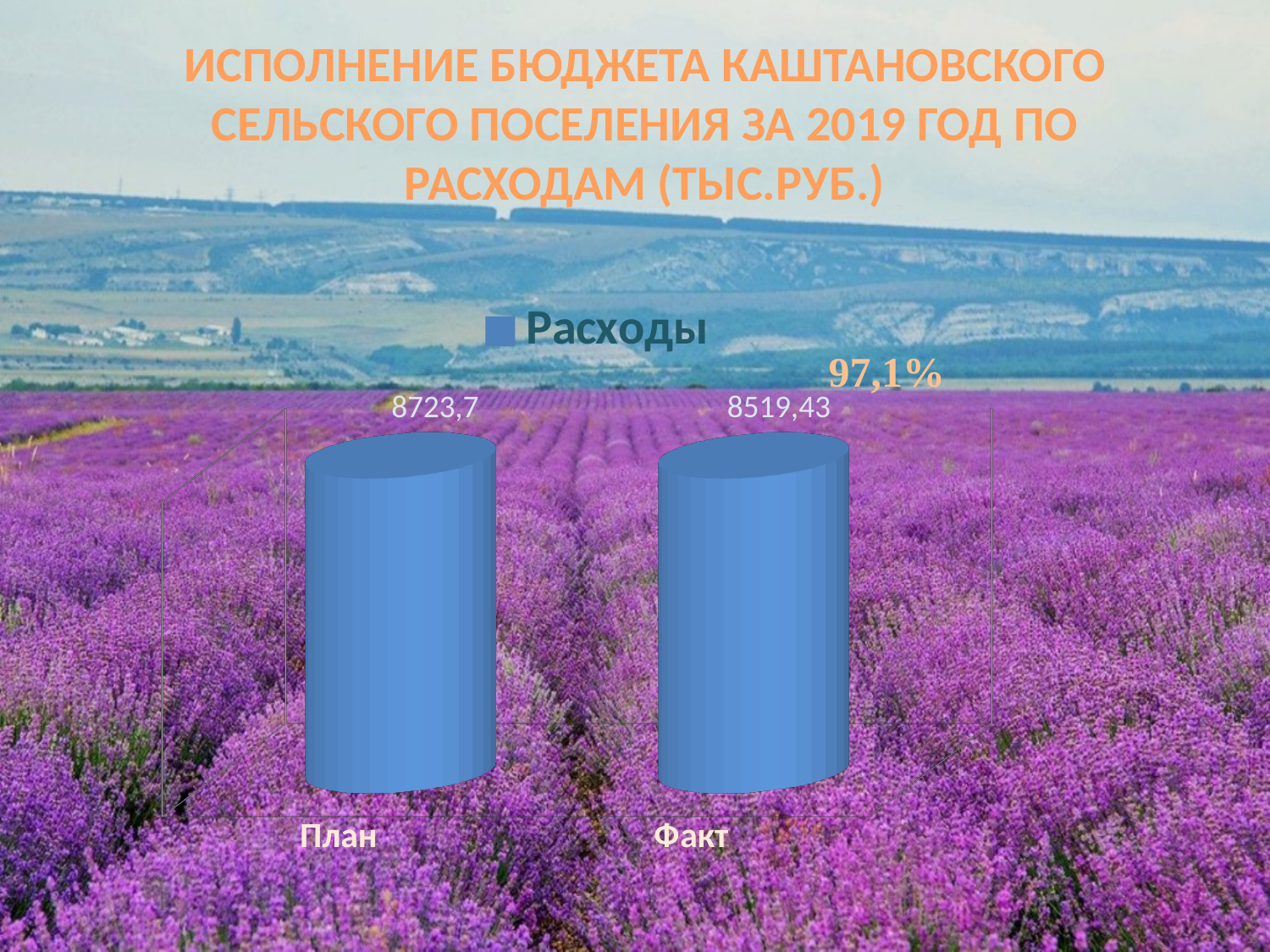
What kind of chart is shown on the slide? Bar chart How many series does the legend list? 1 What is the value for План? 8723,7 How many categories are shown on the chart? 2 What is the difference between the План and Факт values? 204,27 What series name is shown in the chart legend? Расходы Which category has the highest value? План Do the values rise or fall from План to Факт? Fall What percentage is printed above the Факт bar? 97,1% Which category has the higher value, План or Факт? План Which category has the lowest value? Факт What is the value for Факт? 8519,43